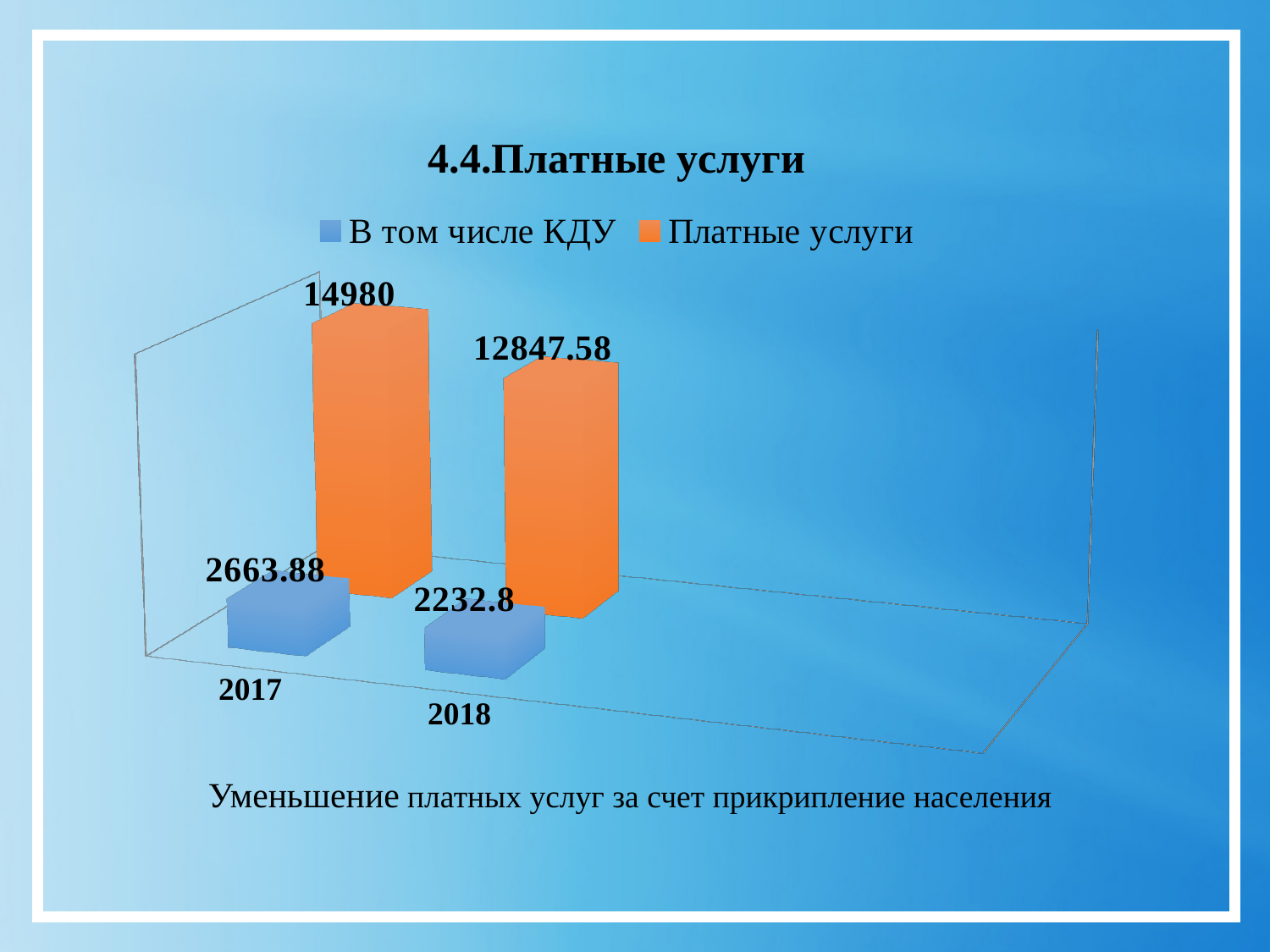
By how much did Платные услуги decrease from 2017 to 2018? 2132.42 What kind of chart is shown on the slide? Bar chart How many series does the legend list? 2 Which is larger in 2018: Платные услуги or В том числе КДУ? Платные услуги In which year is Платные услуги highest? 2017 What is the value of В том числе КДУ for 2017? 2663.88 What is the value of Платные услуги for 2018? 12847.58 What is the value of В том числе КДУ for 2018? 2232.8 What is the value of Платные услуги for 2017? 14980 How many years are shown on the x axis? 2 What is the difference between В том числе КДУ in 2017 and in 2018? 431.08 In which year is В том числе КДУ lowest? 2018